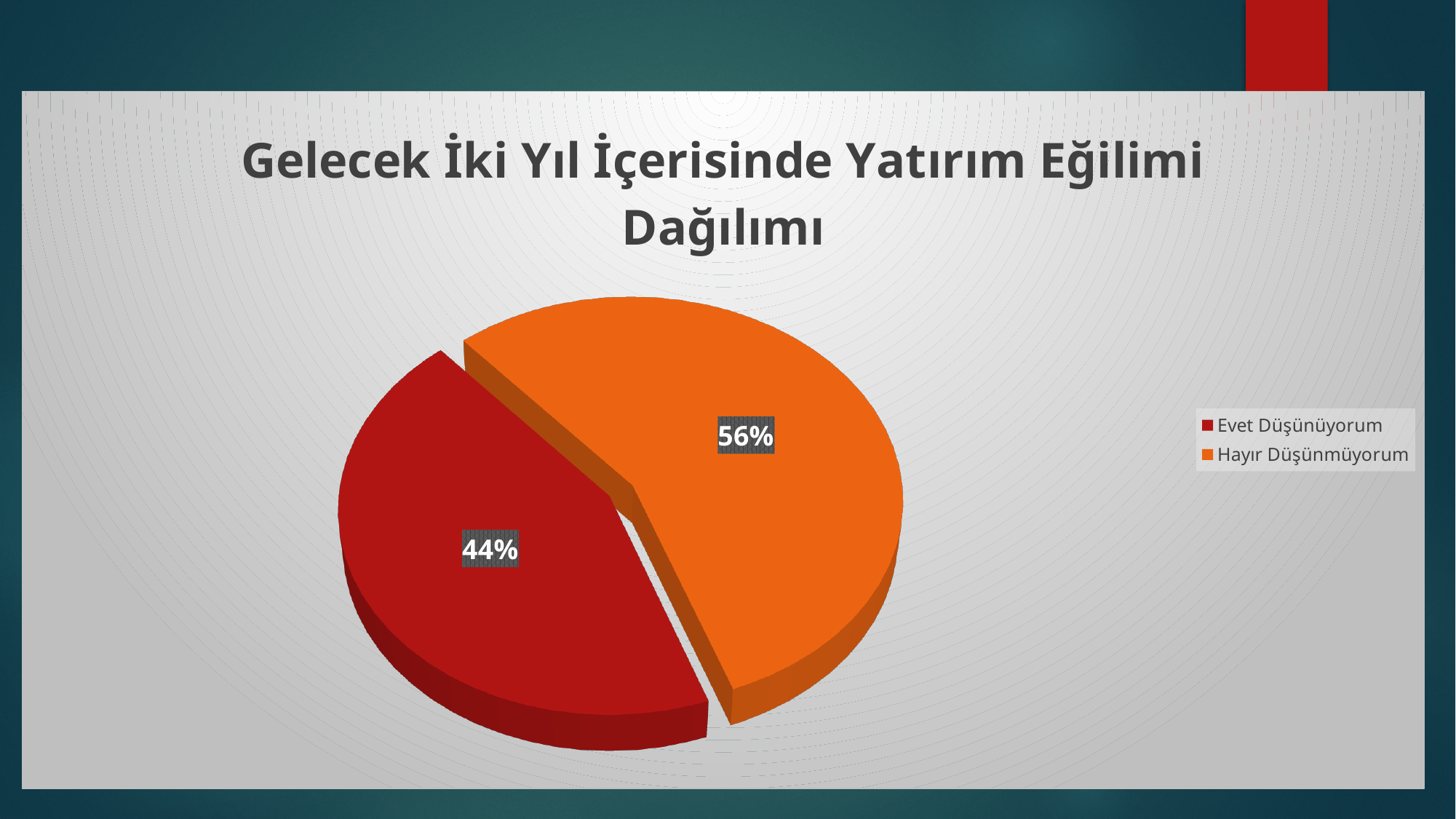
What share of the pie is labelled "Evet Düşünüyorum"? 44% How many entries does the legend list? 2 What is the difference in percentage points between the "Hayır Düşünmüyorum" and "Evet Düşünüyorum" slices? 12 percentage points How many slices does the pie chart have? 2 Which is larger, the "Evet Düşünüyorum" slice or the "Hayır Düşünmüyorum" slice? Hayır Düşünmüyorum What kind of chart is shown on the slide? Pie chart Is the share for "Evet Düşünüyorum" greater or less than 50%? less What is the title of the chart? Gelecek İki Yıl İçerisinde Yatırım Eğilimi Dağılımı What share of the pie is labelled "Hayır Düşünmüyorum"? 56% What colour is the "Evet Düşünüyorum" slice? Red Which slice is the largest? Hayır Düşünmüyorum Which slice is the smallest? Evet Düşünüyorum